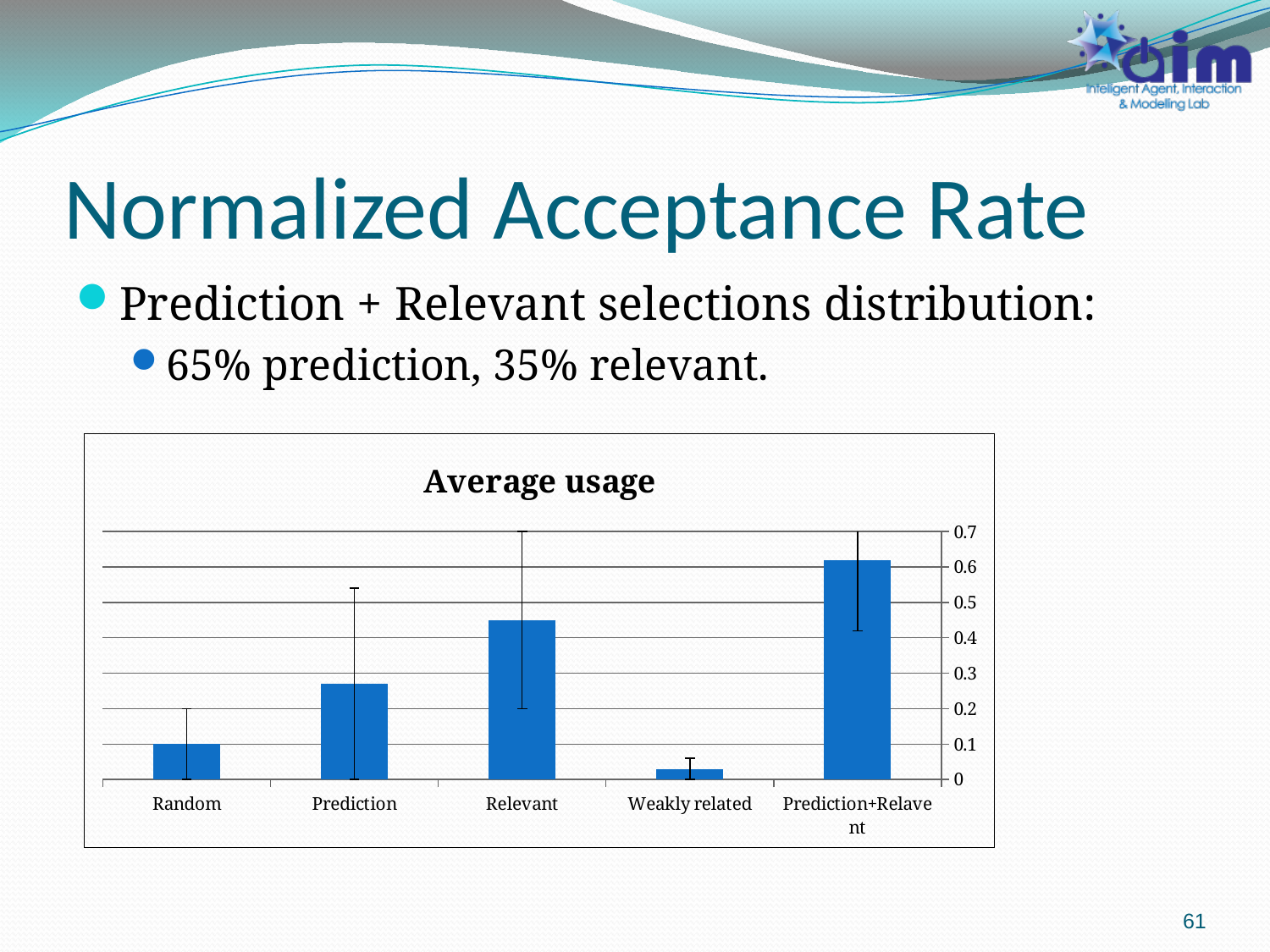
What kind of chart is shown on the slide? bar chart Is the value for Prediction+Relavent greater or less than 0.5? greater Is the value for Relevant greater or less than 0.5? less How many categories are shown on the x axis of the chart? 5 Is the value for Prediction greater or less than 0.3? less What is the title of the chart? Average usage Which has a higher average usage, Relevant or Prediction? Relevant Which category has the lowest average usage? Weakly related What is the highest tick value shown on the y axis of the chart? 0.7 Which has a higher average usage, Random or Weakly related? Random Which category has the highest average usage? Prediction+Relavent